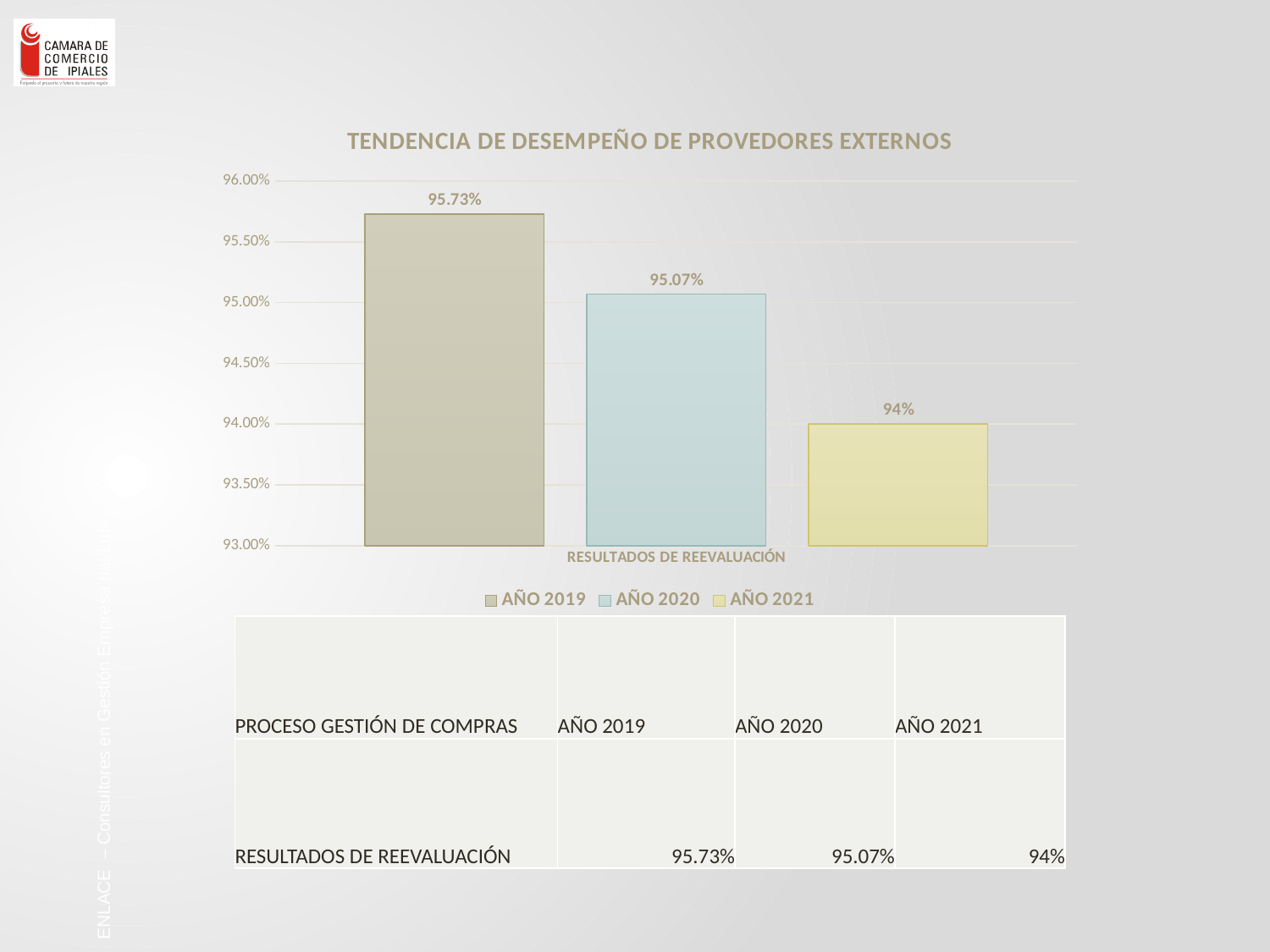
What is the title of the chart? TENDENCIA DE DESEMPEÑO DE PROVEDORES EXTERNOS What kind of chart is shown on the slide? Bar chart What is the value for AÑO 2021 in the chart? 94% Which year has the lowest value in the chart? AÑO 2021 How many series does the legend list? 3 Which is larger, the value for AÑO 2019 or the value for AÑO 2021? AÑO 2019 What is the difference between the values for AÑO 2020 and AÑO 2021? 1.07% What is the difference between the values for AÑO 2019 and AÑO 2020? 0.66% Do the values rise or fall from AÑO 2019 to AÑO 2021? Fall Which year has the highest value in the chart? AÑO 2019 What is the value for AÑO 2020 in the chart? 95.07% What is the value for AÑO 2019 in the chart? 95.73%